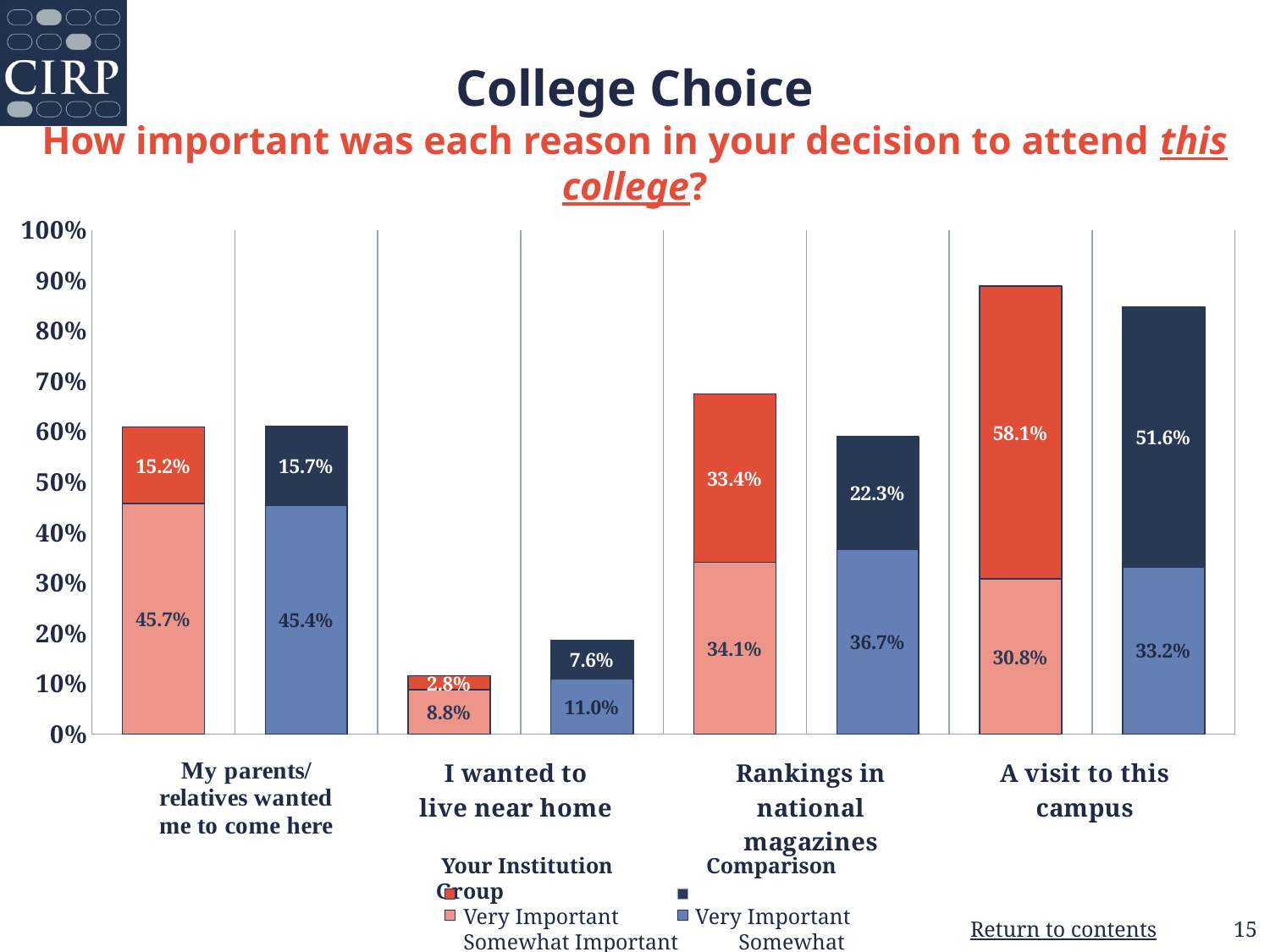
What type of chart is shown on the slide? Stacked bar chart What is the total (Very Important plus Somewhat Important) for Your Institution for 'A visit to this campus'? 88.9% How many reasons (categories) are shown on the x axis? 4 What is the total (Very Important plus Somewhat Important) for the Comparison Group for 'I wanted to live near home'? 18.6% Which reason has the lowest Very Important percentage for the Comparison Group? I wanted to live near home What percentage of students at Your Institution rated 'A visit to this campus' as Very Important? 58.1% For 'A visit to this campus', which group has the larger Very Important percentage, Your Institution or the Comparison Group? Your Institution Which reason has the highest Very Important percentage for Your Institution? A visit to this campus How many series does the legend list? 4 What is the difference between Your Institution's and the Comparison Group's Very Important percentages for 'Rankings in national magazines'? 11.1% What percentage of students at Your Institution rated 'I wanted to live near home' as Very Important? 2.8% What percentage of the Comparison Group rated 'Rankings in national magazines' as Somewhat Important? 36.7%